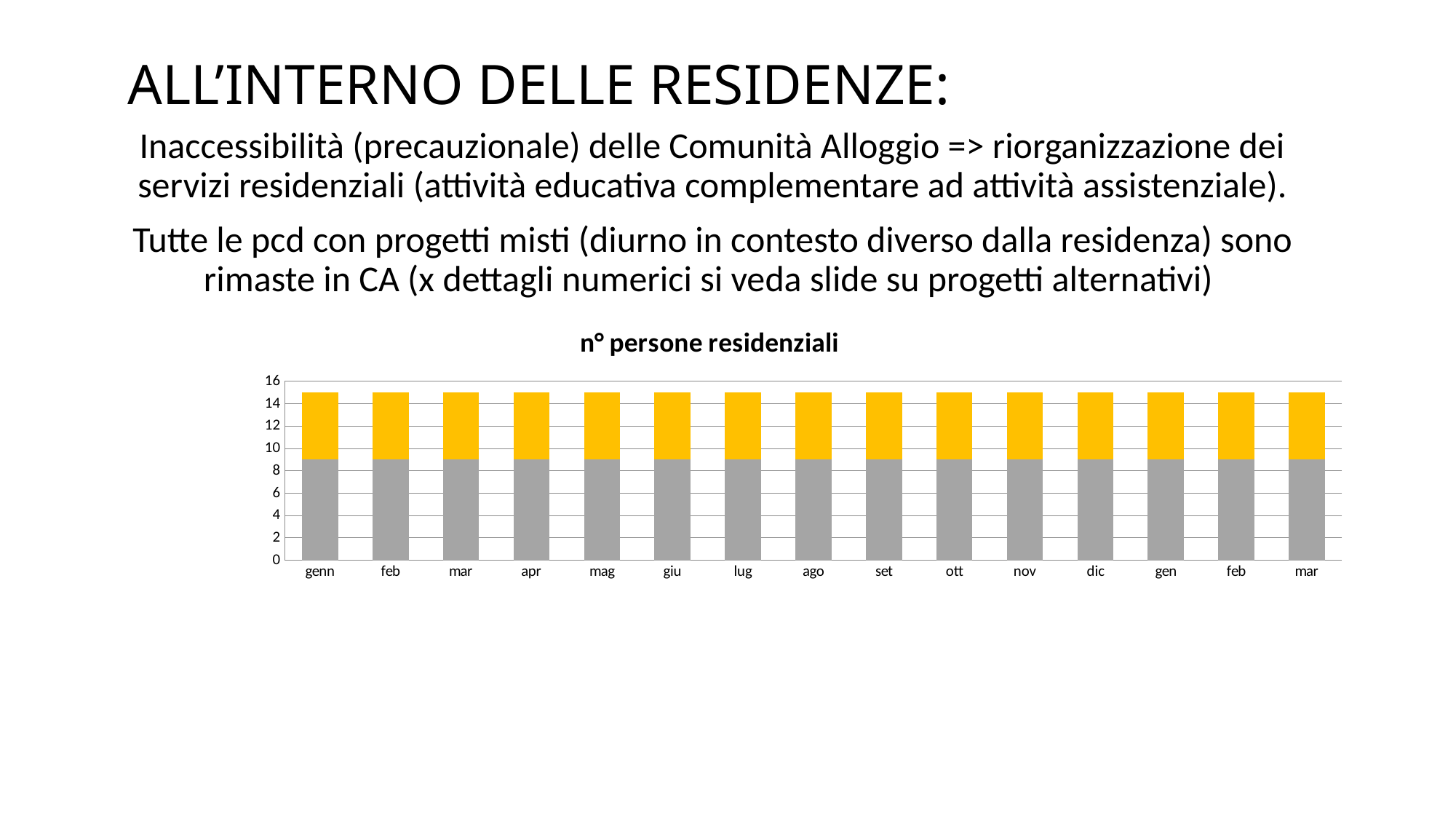
What kind of chart is shown on the slide? bar chart Is the grey segment of the bar for dic greater or less than 10? less Do the total bar heights rise, fall, or stay the same across the months on the x axis? stay the same What is the title of the chart? n° persone residenziali Is the total height of the bar for mar (the last category) greater or less than 16? less How many categories are shown along the x axis of the chart? 15 Is the total height of the bar for genn greater or less than 14? greater What is the highest value shown on the y axis of the chart? 16 What is the first category label on the x axis of the chart? genn